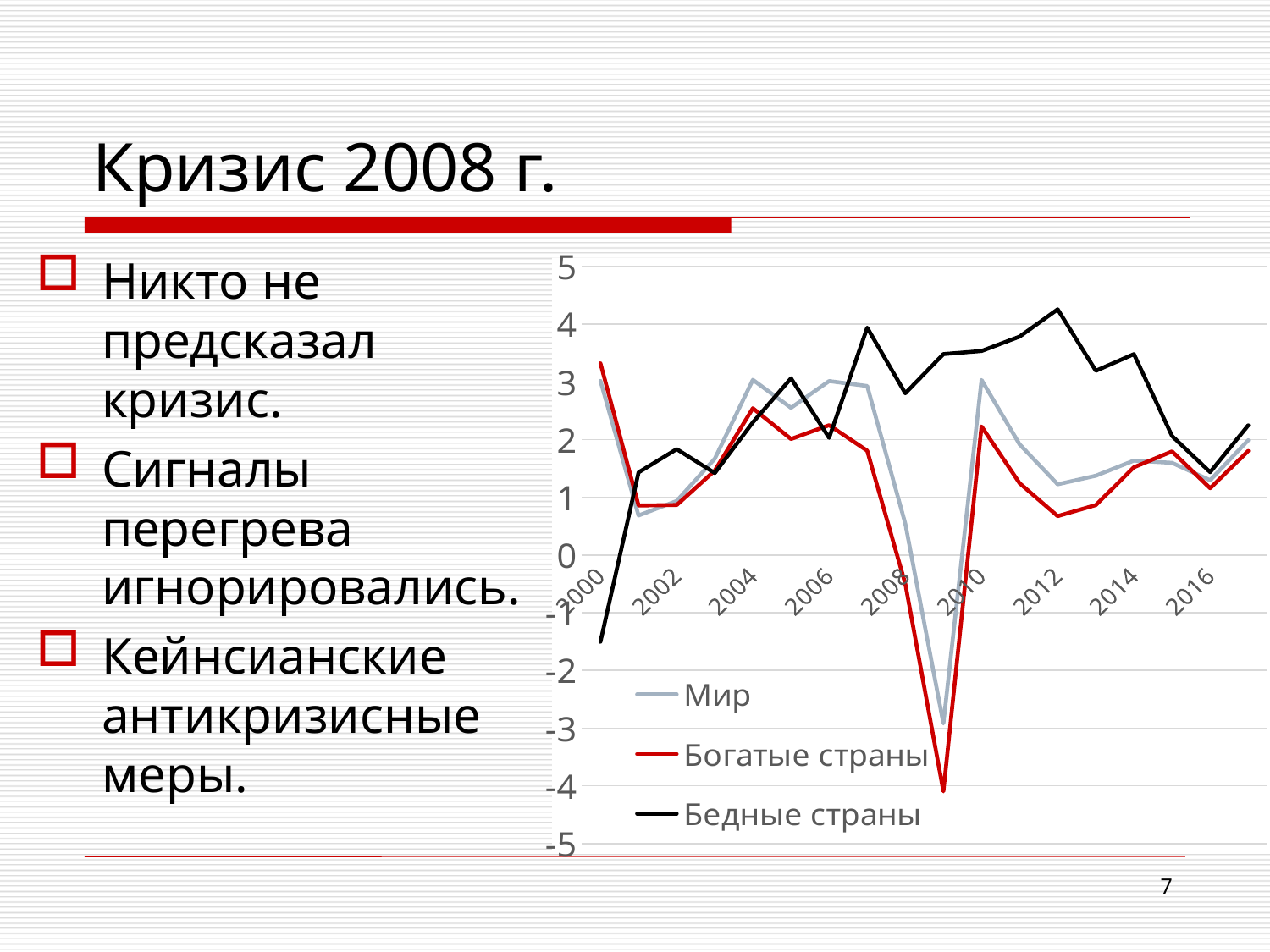
Does the Богатые страны line rise or fall between 2007 and 2009? fall Which series reaches the lowest point anywhere on the chart? Богатые страны In 2012, which series has the higher value, Бедные страны or Богатые страны? Бедные страны What colour is the line for Богатые страны? red Is the value for Богатые страны in 2009 greater or less than -3? less Is the value for Бедные страны in 2000 greater or less than 0? less In 2009, which series has the lower value, Мир or Богатые страны? Богатые страны Is the value for Бедные страны in 2012 greater or less than 3? greater What are the three series named in the chart legend? Мир, Богатые страны, Бедные страны What kind of chart is shown on the slide? line chart How many series does the chart legend list? 3